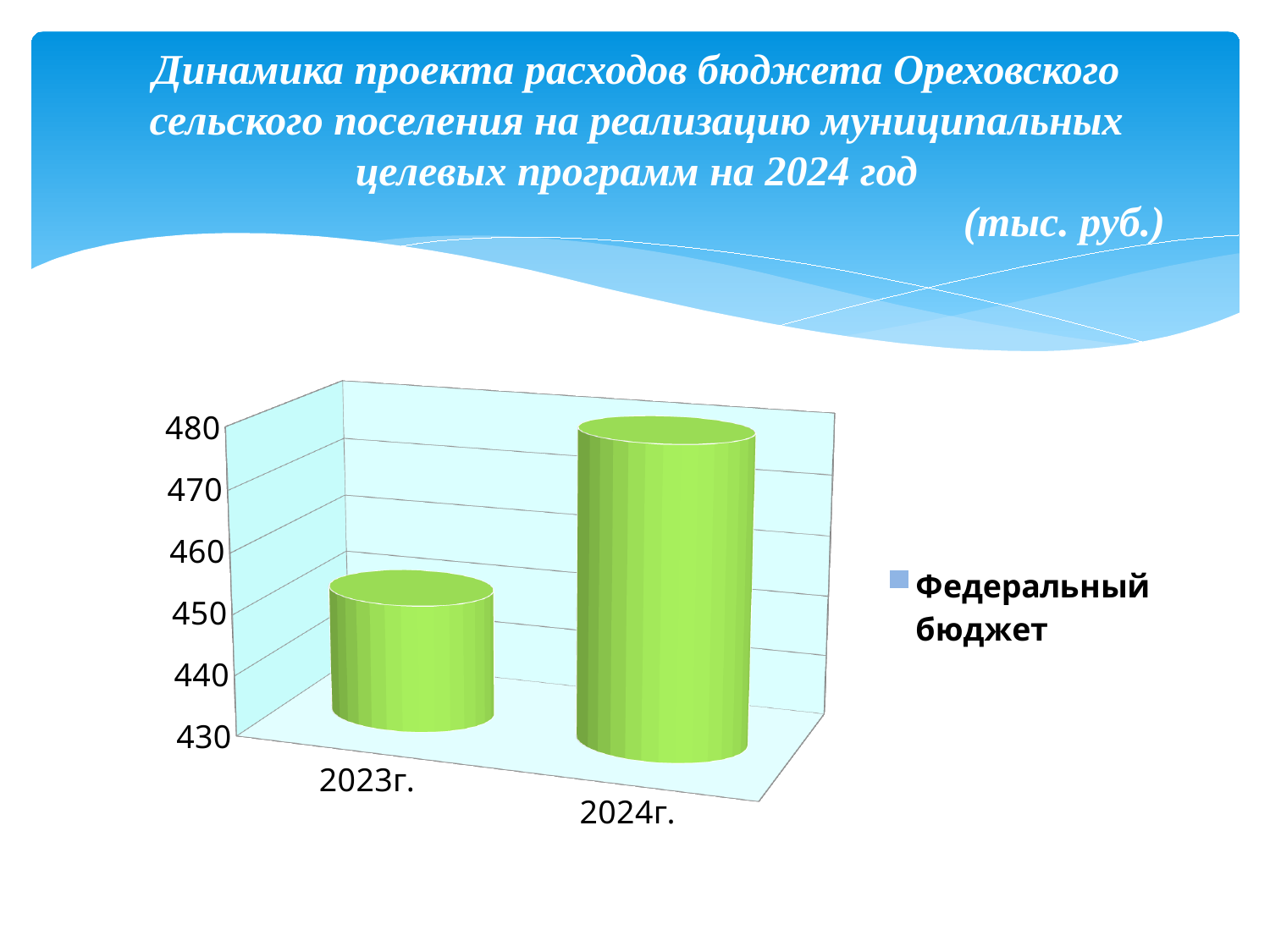
Do the values rise or fall from 2023г. to 2024г.? rise What series name is shown in the chart legend? Федеральный бюджет Is the value for 2023г. greater or less than 460? less What is the lowest value shown on the vertical axis of the chart? 430 Which year has the highest value in the chart? 2024г. Is the value for 2023г. greater or less than 440? greater Which is larger, the value for 2023г. or the value for 2024г.? 2024г. Which year has the lowest value in the chart? 2023г. How many categories are shown on the x axis of the chart? 2 Is the value for 2024г. greater or less than 470? greater What kind of chart is shown on the slide? bar chart How many series does the chart legend list? 1